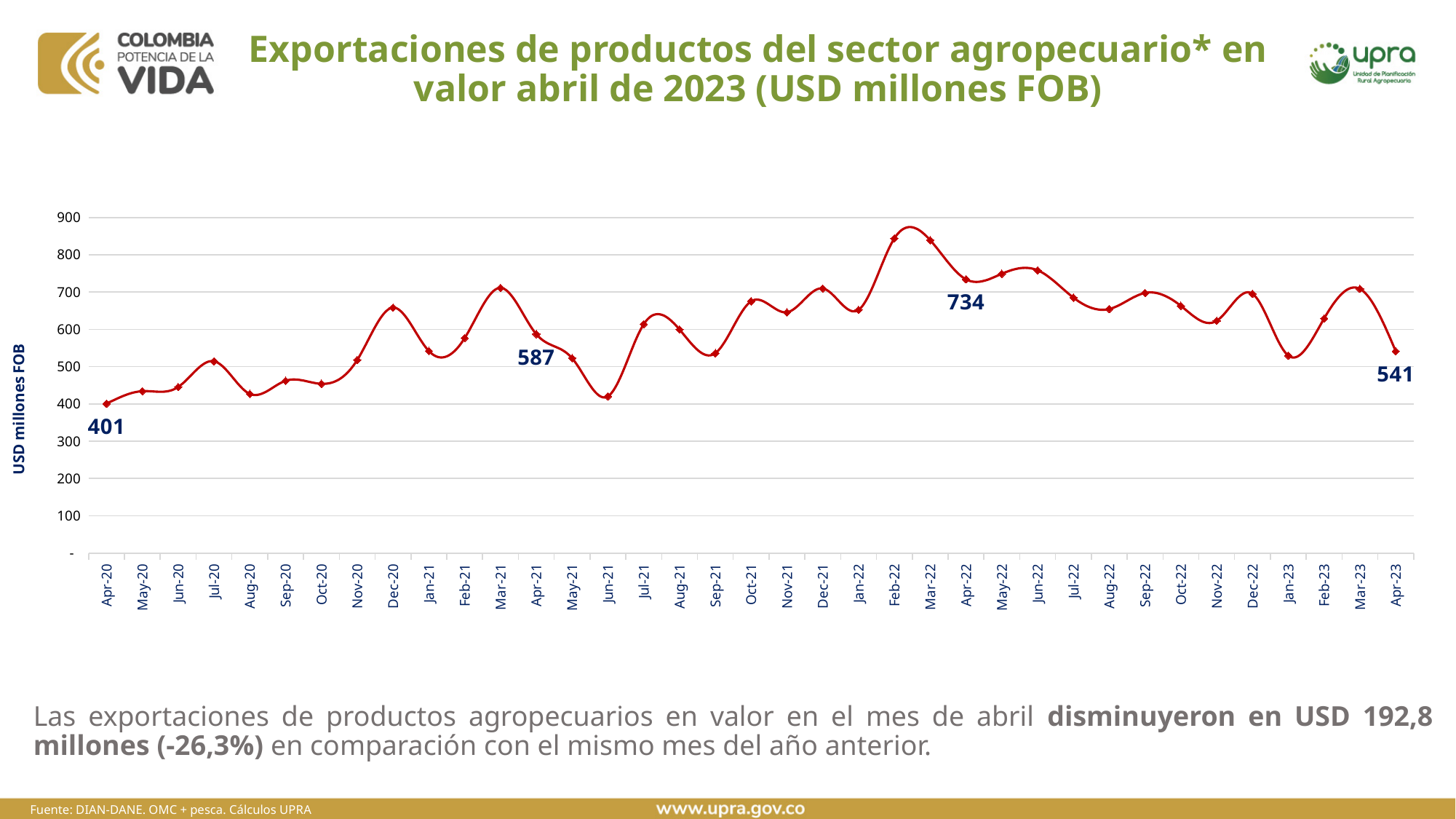
What is the value for Apr-20? 401 Is the value for Feb-22 greater or less than 800? greater Which is larger, the value for Apr-22 or the value for Apr-21? Apr-22 What is the value for Apr-21? 587 What kind of chart is shown on the slide? line chart Is the value for Jun-21 greater or less than 500? less What is the difference between the values for Apr-22 and Apr-23? 193 What is the value for Apr-22? 734 Which month has the highest value on the chart? Feb-22 What is the difference between the values for Apr-21 and Apr-20? 186 What is the value for Apr-23? 541 What is the label on the vertical axis of the chart? USD millones FOB